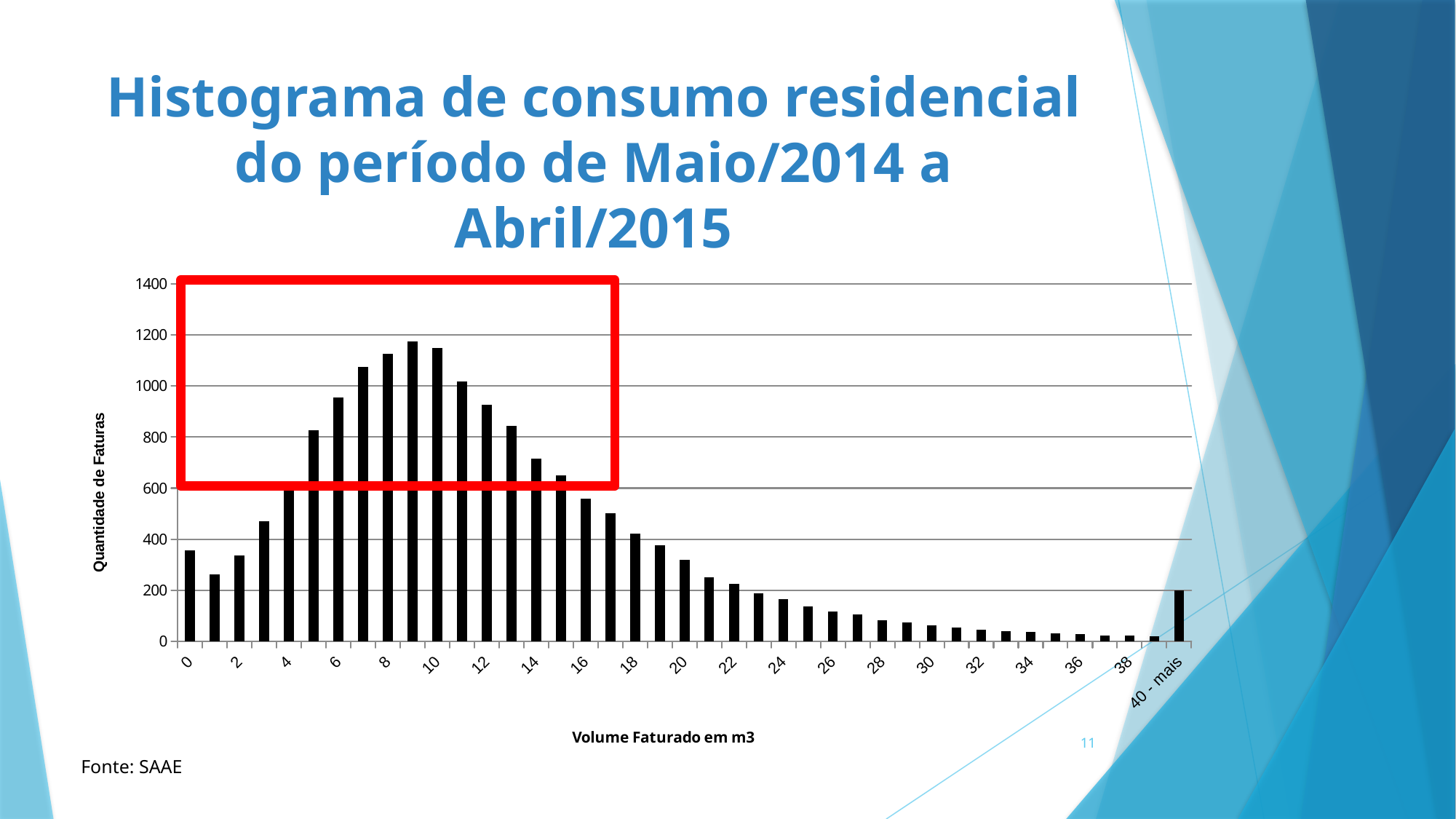
Which has a larger value, volume 0 or volume 1? 0 Do the values rise or fall along the x axis from volume 9 to volume 39? fall Is the value for volume 14 greater or less than 600? greater Is the value for volume 20 greater or less than 400? less Is the value for volume 16 greater or less than 600? less Which volume category has the highest number of invoices (Quantidade de Faturas)? 9 Which has a larger value, volume 18 or the '40 - mais' category? 18 What kind of chart is shown on the slide? bar chart What is the title of the vertical axis? Quantidade de Faturas